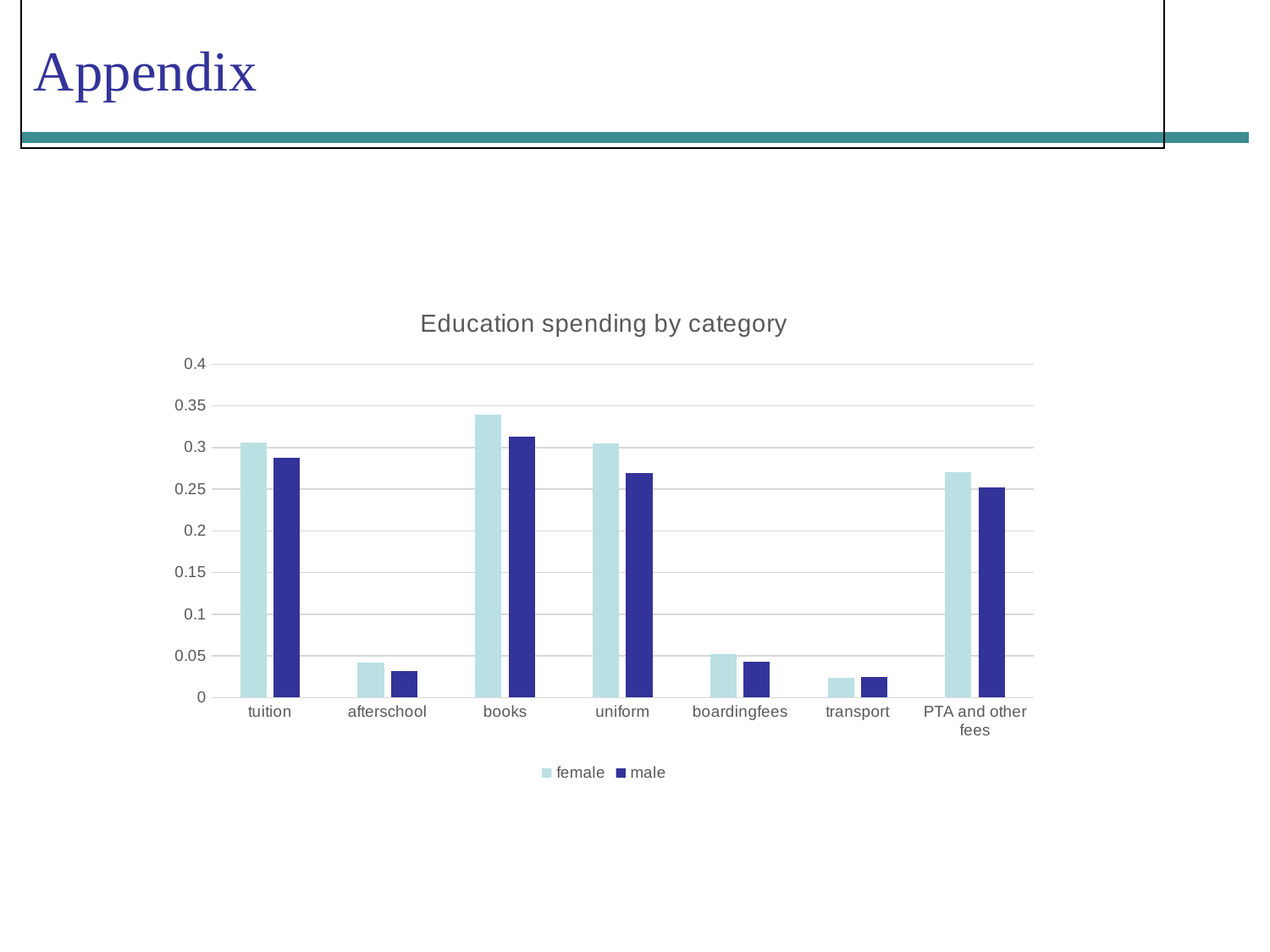
Is the female value for books greater or less than 0.3? greater What type of chart is shown on the slide? bar chart Is the male value for tuition greater or less than 0.3? less Which category has the highest value for the female series? books Is the female value for PTA and other fees greater or less than 0.25? greater For uniform, which series has the larger value, female or male? female How many categories are shown on the x axis? 7 What is the title of the chart? Education spending by category Which category has the lowest value for the female series? transport How many series does the legend list? 2 Which category has the highest value for the male series? books